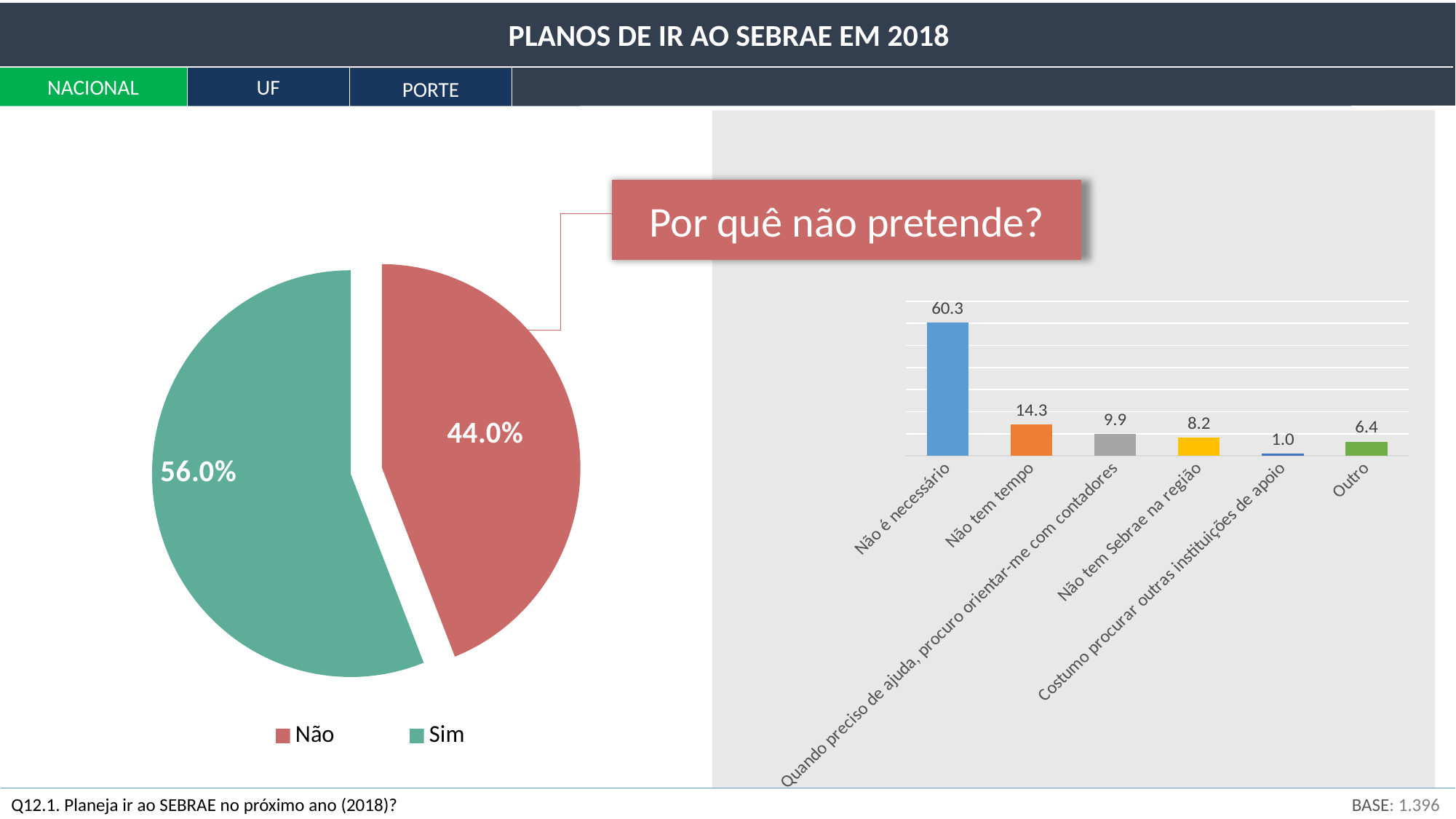
How many entries does the legend of the pie chart on the left list? 2 In the bar chart on the right ("Por quê não pretende?"), what is the value for "Não tem tempo"? 14.3 In the pie chart on the left, what percentage is shown for "Sim"? 56.0% What type of chart is shown on the left side of the slide? Pie chart In the bar chart on the right ("Por quê não pretende?"), which category has the lowest value? Costumo procurar outras instituições de apoio In the bar chart on the right ("Por quê não pretende?"), what is the value for "Não é necessário"? 60.3 In the bar chart on the right ("Por quê não pretende?"), which category has the highest value? Não é necessário In the pie chart on the left, what percentage is shown for "Não"? 44.0% In the bar chart on the right ("Por quê não pretende?"), what is the difference between "Não tem tempo" and "Outro"? 7.9 In the bar chart on the right ("Por quê não pretende?"), how many categories are plotted? 6 In the pie chart on the left, what is the difference in percentage points between "Sim" and "Não"? 12.0 In the pie chart on the left, which slice is larger, "Sim" or "Não"? Sim